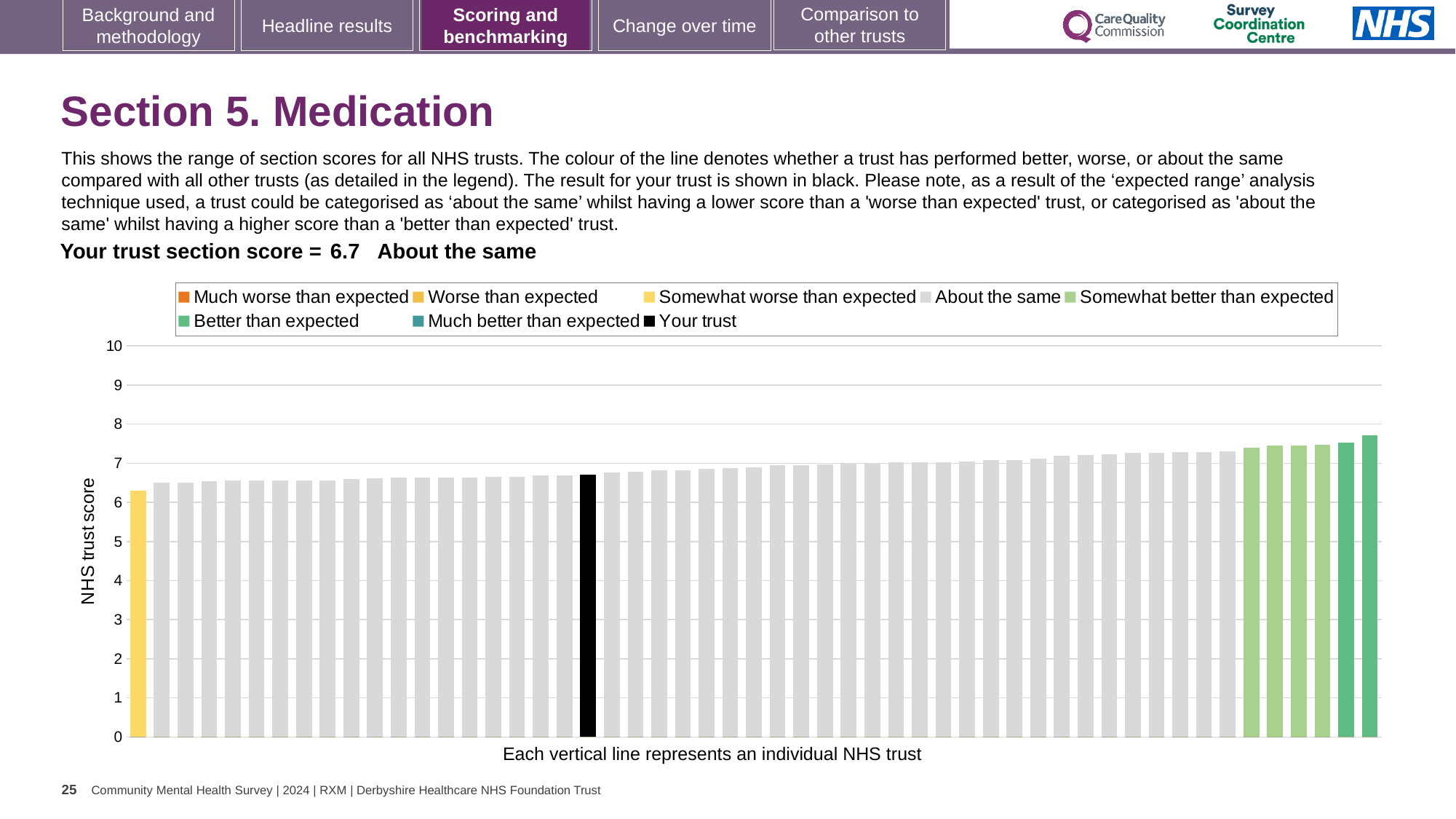
How many bars are coloured as 'Better than expected' (the darker green)? 2 What kind of chart is shown on the slide? bar chart What is the label on the vertical axis of the chart? NHS trust score Do the bar values rise or fall from left to right across the chart? rise How many entries does the chart legend list? 8 What colour is the bar representing your trust? black Is your trust's bar higher or lower than the tallest green bar? lower What is your trust's section score for Section 5. Medication? 6.7 Is your trust's section score greater or less than 7? less Is the value of the lowest bar greater or less than 6? greater Is the value of the highest bar greater or less than 8? less How is your trust's score categorised compared with other trusts? About the same